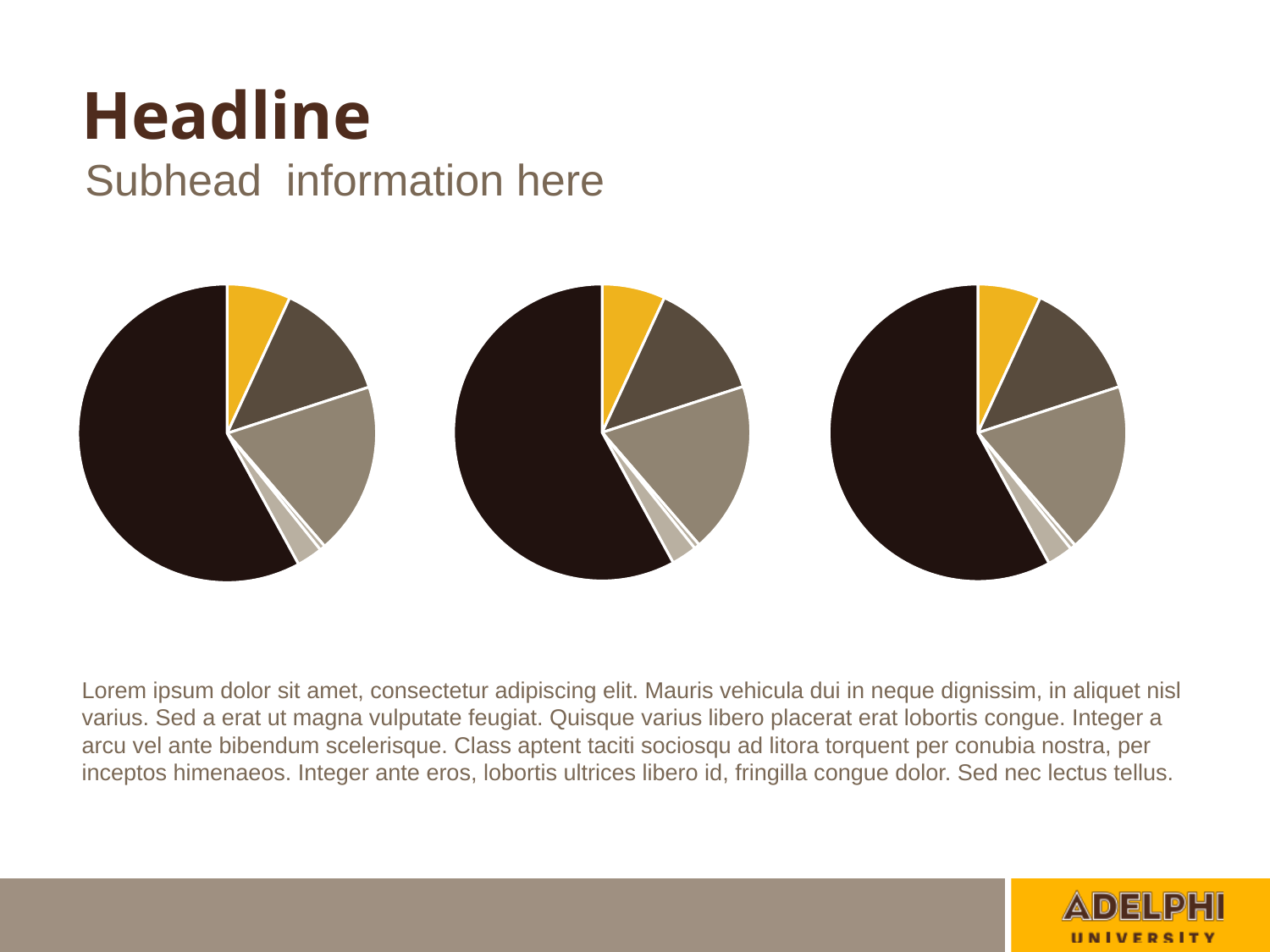
What kind of chart is the left chart on the slide? pie chart What kind of chart is the middle chart on the slide? pie chart In the right pie chart, which colour slice is the largest? dark brown How many pie charts are shown on the slide? 3 Does the slide show a legend for the pie charts? No What kind of chart is the right chart on the slide? pie chart In the left pie chart, which colour slice is the largest? dark brown